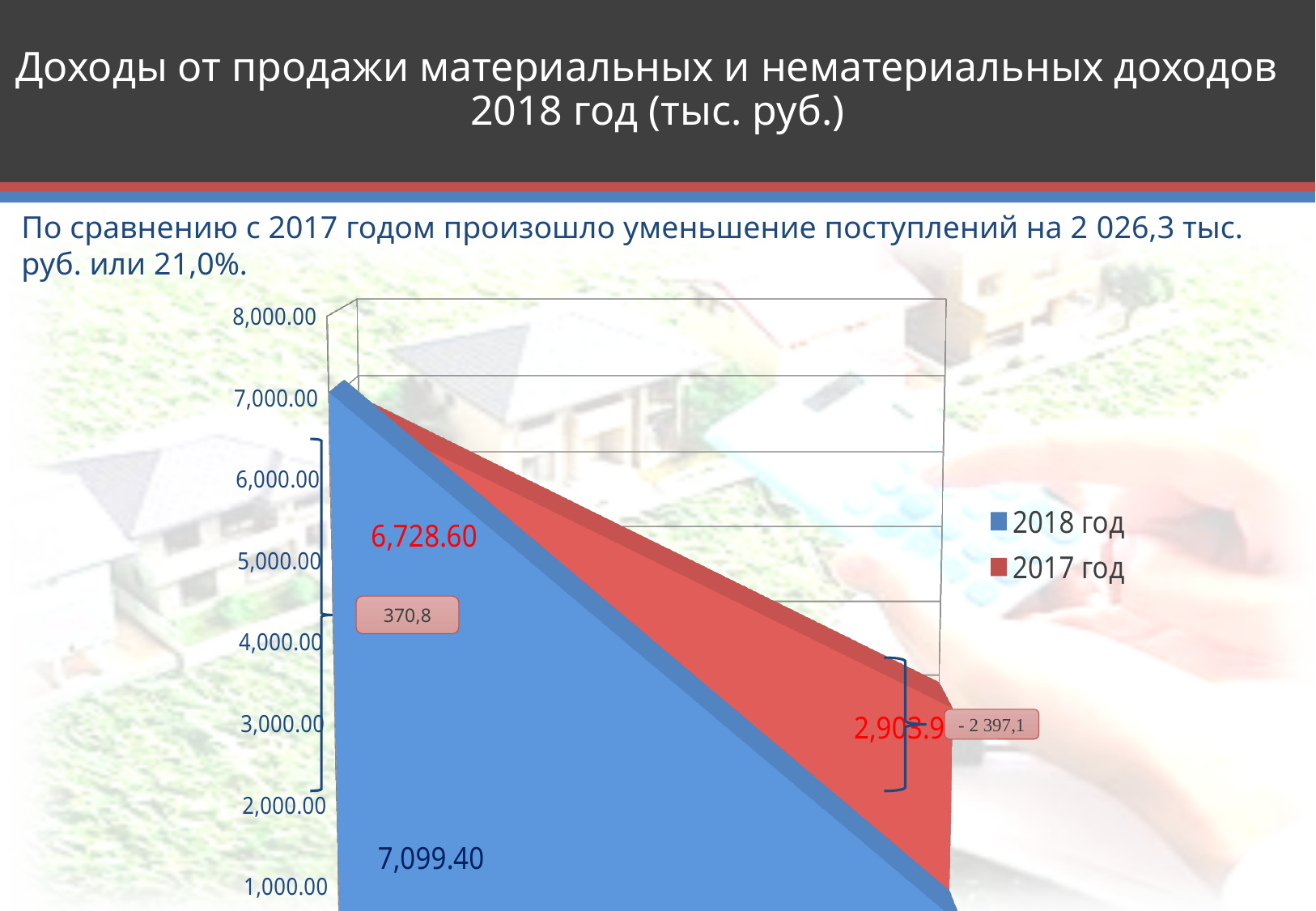
What are the two entries in the chart legend? 2018 год and 2017 год What value is shown in the callout box on the left side of the chart? 370,8 What value is shown in the callout box on the right side of the chart? - 2 397,1 What colour represents the 2018 год series in the chart? blue Which series has the larger value at the left of the chart, 2018 год or 2017 год? 2018 год Is the left-hand value of the 2017 год series greater or less than 6,000.00? greater How many series does the chart legend list? 2 What value is labelled on the 2017 год (red) series at the left of the chart? 6,728.60 What value is labelled on the 2018 год (blue) series at the left of the chart? 7,099.40 Do the values of the series rise or fall from left to right along the x axis? fall What is the difference between the left-hand values of the 2018 год series (7,099.40) and the 2017 год series (6,728.60)? 370.80 What kind of chart is shown on the slide? area chart